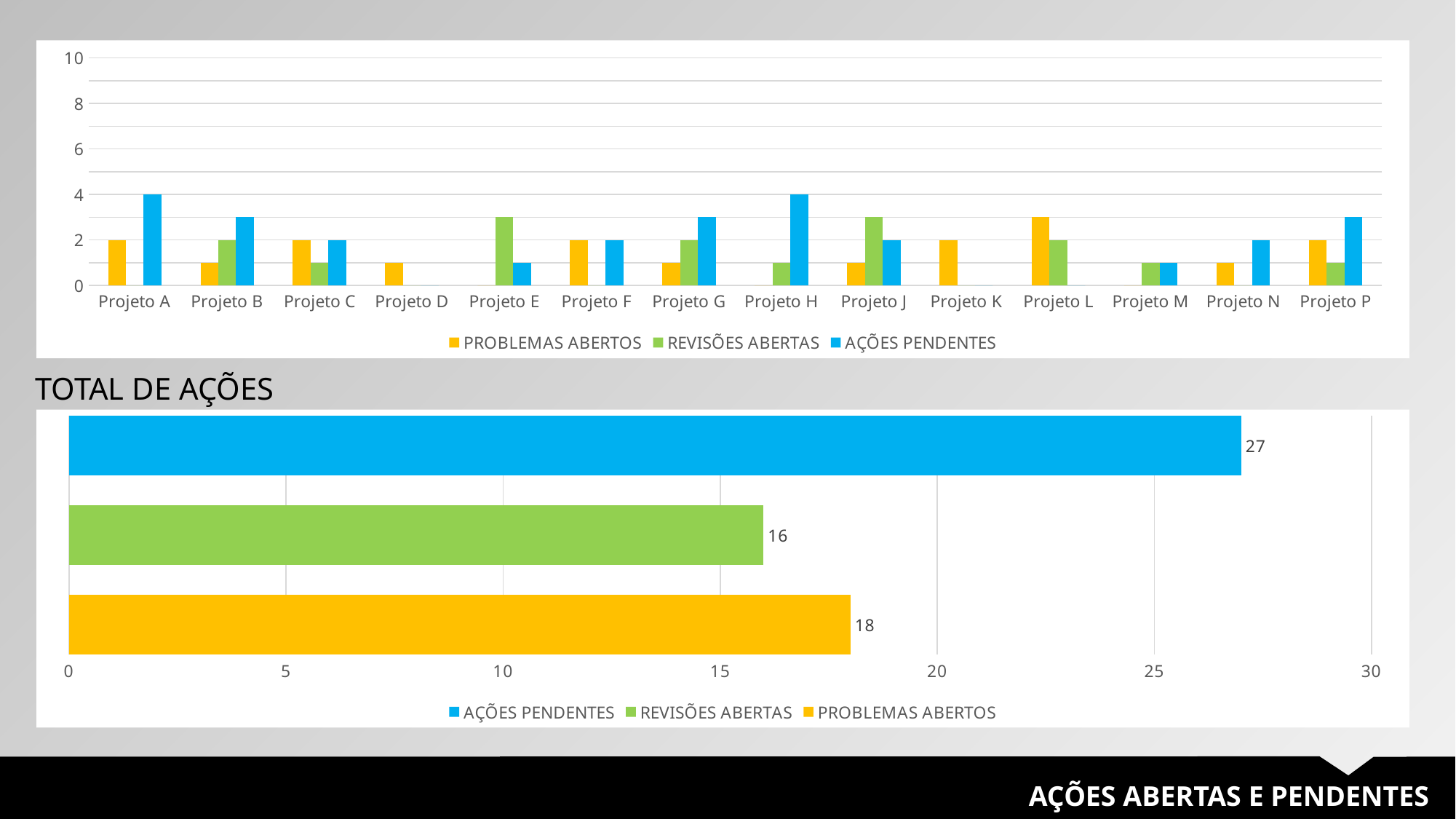
In the bottom chart titled TOTAL DE AÇÕES, what is the value for REVISÕES ABERTAS? 16 In the bottom chart titled TOTAL DE AÇÕES, is the value for PROBLEMAS ABERTOS greater or less than 20? less What kind of chart is the bottom chart titled TOTAL DE AÇÕES? bar chart In the bottom chart titled TOTAL DE AÇÕES, which series has the highest value? AÇÕES PENDENTES In the top chart, how many series does the legend list? 3 In the bottom chart titled TOTAL DE AÇÕES, which series has the lowest value? REVISÕES ABERTAS In the top chart, what is the value of AÇÕES PENDENTES for Projeto A? 4 In the bottom chart titled TOTAL DE AÇÕES, what is the difference between AÇÕES PENDENTES and PROBLEMAS ABERTOS? 9 In the bottom chart titled TOTAL DE AÇÕES, what is the value for AÇÕES PENDENTES? 27 In the top chart, which is larger for Projeto L: PROBLEMAS ABERTOS or REVISÕES ABERTAS? PROBLEMAS ABERTOS In the top chart, how many projects are shown on the x axis? 14